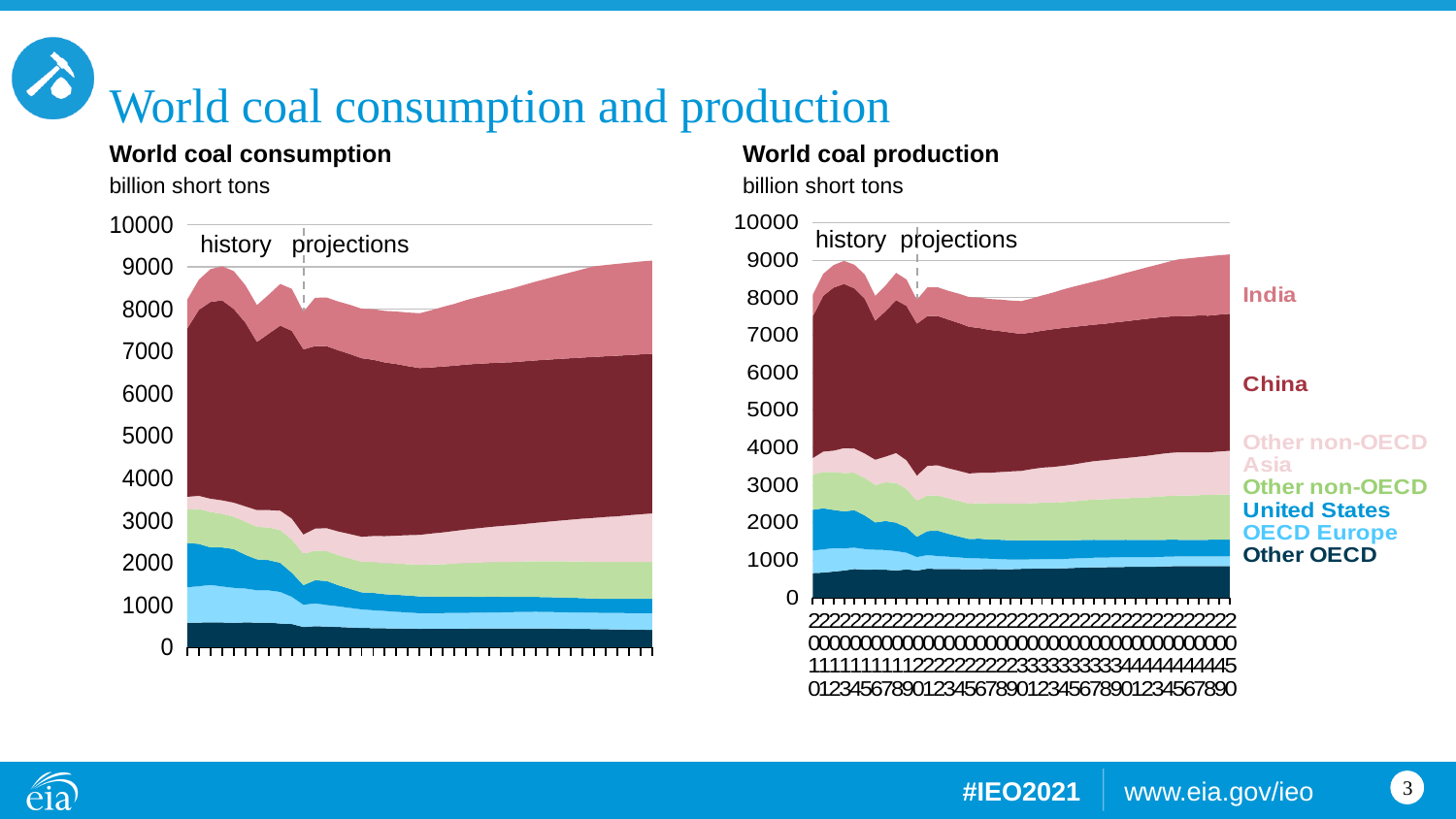
In the 'World coal production' chart, what is the last year shown on the x axis? 2050 What kind of chart is the 'World coal consumption' chart? stacked area chart In the 'World coal production' chart, does total production rise or fall between 2030 and 2050? rise In the 'World coal production' chart, is the total production in 2050 greater or less than 8000? greater In the 'World coal production' chart, is the total production in 2010 greater or less than 9000? less In the 'World coal consumption' chart, is the total consumption at the right end of the chart greater or less than 8000? greater In the 'World coal production' chart, how many series are labelled on the right side of the chart? 7 In the 'World coal production' chart, what is the first year shown on the x axis? 2010 In the 'World coal production' chart, which series is at the top of the stack? India What kind of chart is the 'World coal production' chart? stacked area chart What unit is used on the y axis of the 'World coal consumption' chart? billion short tons In the 'World coal production' chart, which series is at the bottom of the stack? Other OECD